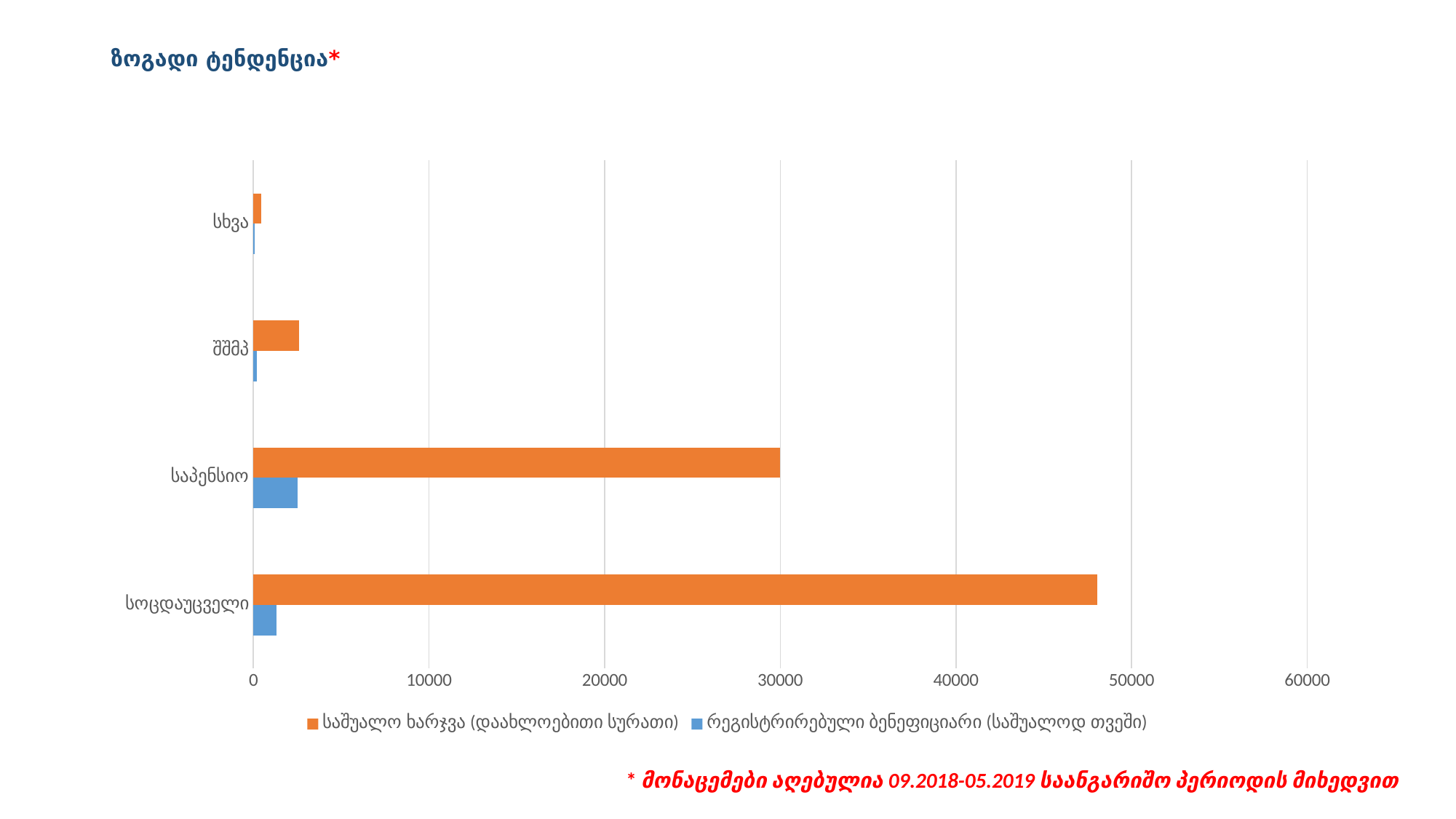
Which category has the highest value for საშუალო ხარჯვა (დაახლოებითი სურათი)? სოცდაუცველი Which category has the highest value for რეგისტრირებული ბენეფიციარი (საშუალოდ თვეში)? საპენსიო What is the title of the chart slide? ზოგადი ტენდენცია* Is the value of საშუალო ხარჯვა (დაახლოებითი სურათი) for სოცდაუცველი greater or less than 40000? greater What kind of chart is shown on the slide? bar chart Is the value of რეგისტრირებული ბენეფიციარი (საშუალოდ თვეში) for საპენსიო greater or less than 10000? less Which colour represents რეგისტრირებული ბენეფიციარი (საშუალოდ თვეში) in the legend? blue How many categories are shown on the chart? 4 Is the value of საშუალო ხარჯვა (დაახლოებითი სურათი) for სოცდაუცველი greater or less than 50000? less How many series does the legend list? 2 Which category has the lowest value for საშუალო ხარჯვა (დაახლოებითი სურათი)? სხვა Which is larger: the საშუალო ხარჯვა (დაახლოებითი სურათი) value for სოცდაუცველი or for საპენსიო? სოცდაუცველი